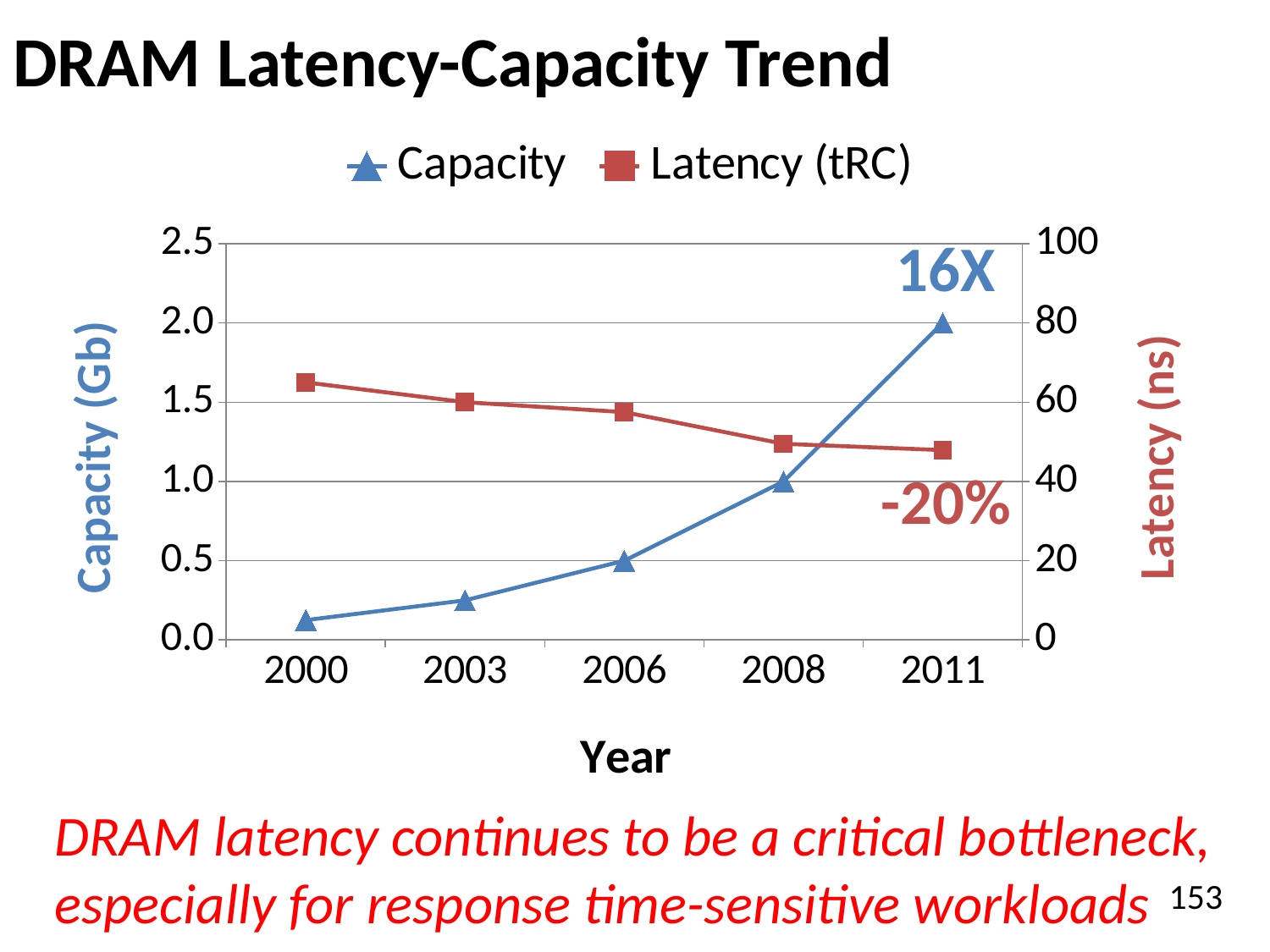
In which year is Capacity lowest? 2000 What is the Capacity value for 2008? 1.0 Does the Latency (tRC) series rise or fall from 2000 to 2011? fall Is the Capacity value for 2006 greater or less than 1.0? less What is the Capacity value for 2011? 2.0 Is the Latency (tRC) value for 2000 greater or less than 60? greater In which year is Latency (tRC) highest? 2000 What kind of chart is shown on the slide? line chart What is the difference between the Capacity values for 2011 and 2008? 1.0 Does the Capacity series rise or fall from 2000 to 2011? rise How many series does the legend list? 2 How many years are plotted along the x axis? 5